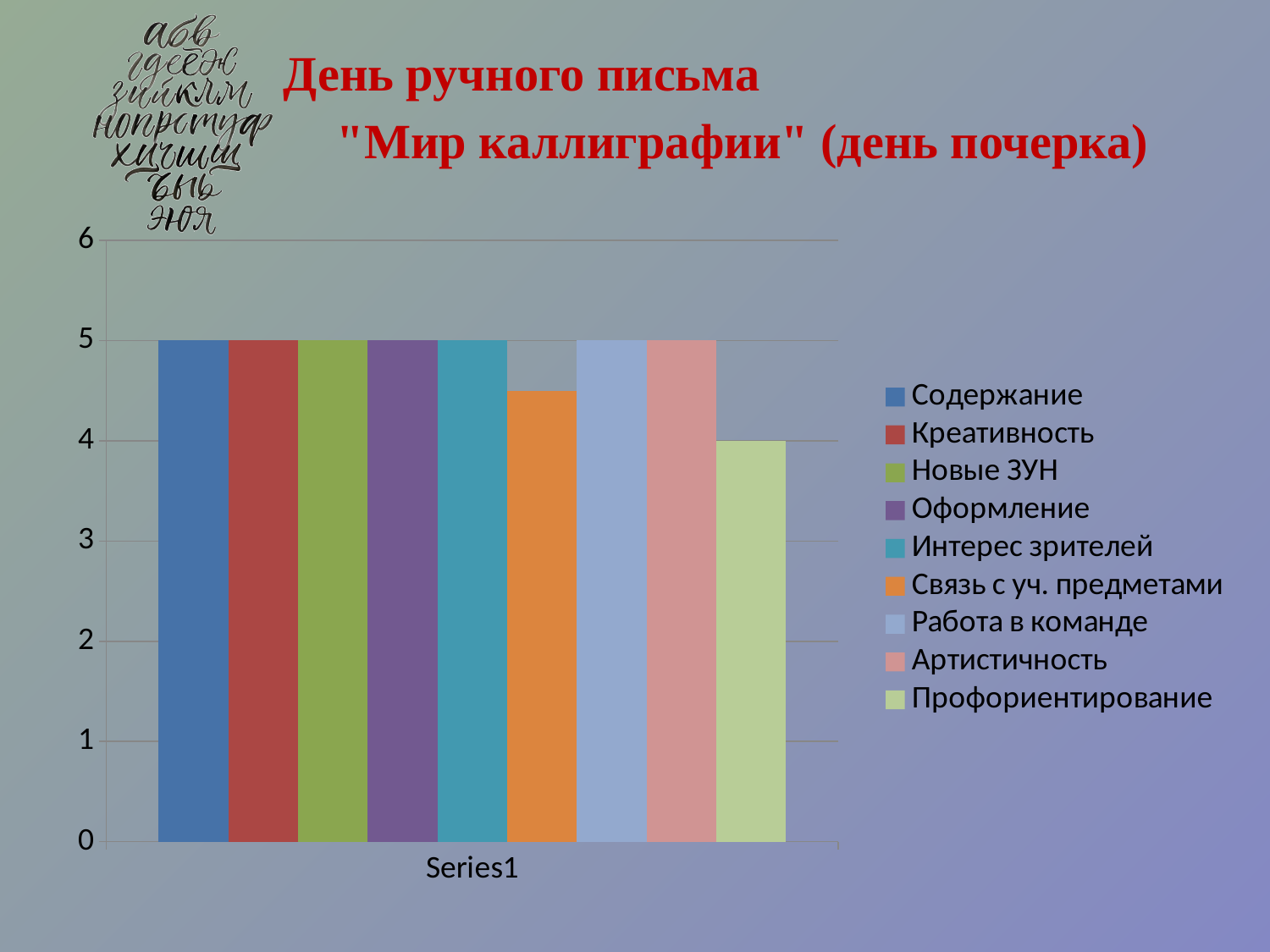
Which is larger, the value for Креативность or the value for Профориентирование? Креативность What kind of chart is shown on the slide? bar chart What is the value for Профориентирование? 4 Is the value for Связь с уч. предметами greater or less than 4? greater What is the value for Содержание? 5 How many bars are plotted in the chart? 9 What is the difference between the value for Содержание and the value for Профориентирование? 1 Which series has the lowest value? Профориентирование How many series does the legend list? 9 Is the value for Связь с уч. предметами greater or less than 5? less What is the value for Артистичность? 5 What is the category label shown on the x axis? Series1